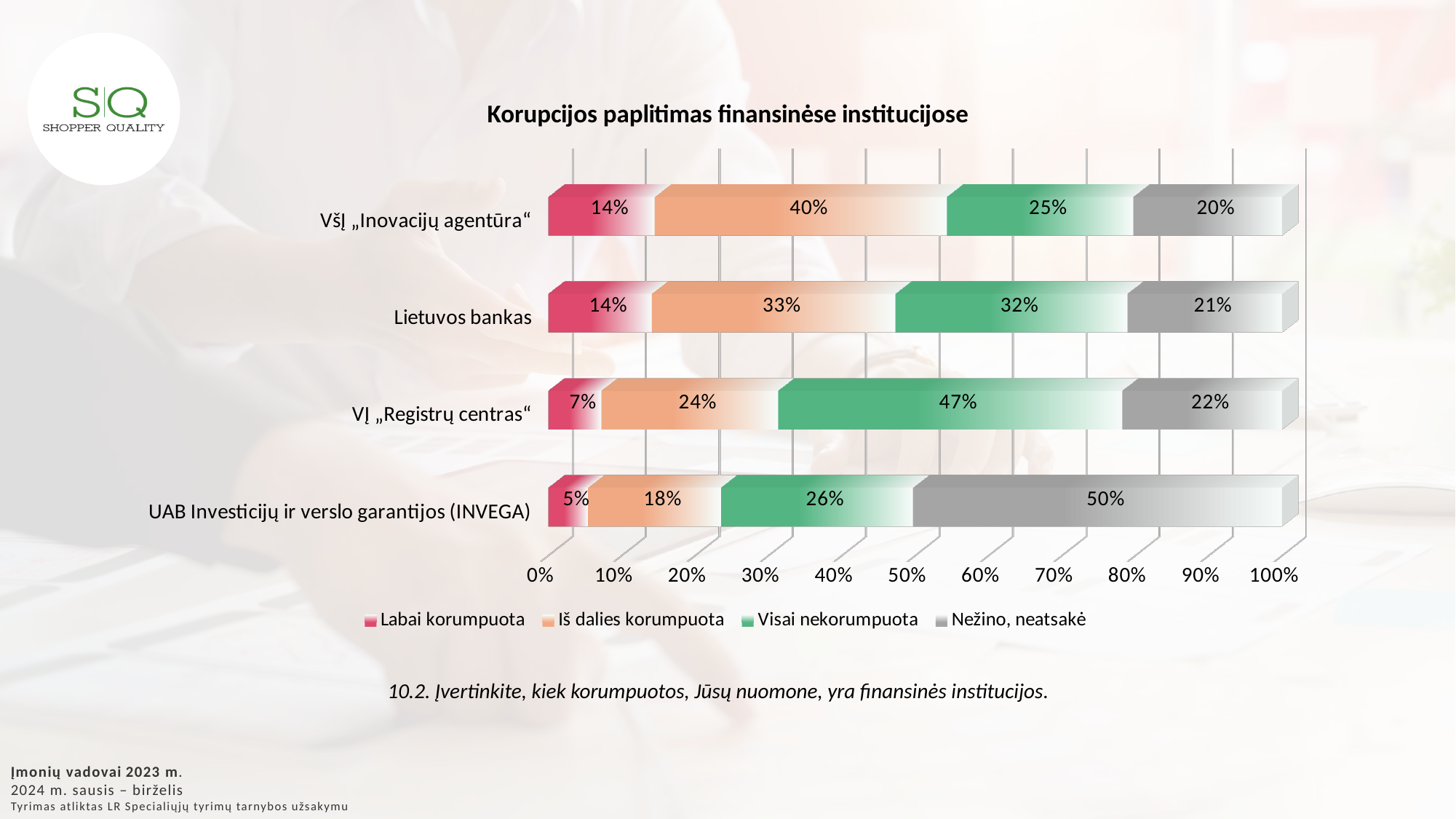
What is the value of "Nežino, neatsakė" for UAB Investicijų ir verslo garantijos (INVEGA)? 50% What is the title of the chart? Korupcijos paplitimas finansinėse institucijose What is the difference between the "Nežino, neatsakė" values for UAB Investicijų ir verslo garantijos (INVEGA) and VšĮ „Inovacijų agentūra“? 30% Which institution has the highest "Visai nekorumpuota" value? VĮ „Registrų centras“ How many series does the legend list? 4 How many institutions are shown on the chart? 4 What kind of chart is shown on the slide? Stacked bar chart What is the value of "Visai nekorumpuota" for VĮ „Registrų centras“? 47% Which institution has the lowest "Labai korumpuota" value? UAB Investicijų ir verslo garantijos (INVEGA) What is the value of "Labai korumpuota" for Lietuvos bankas? 14% Which is larger: the "Iš dalies korumpuota" value for Lietuvos bankas or for VĮ „Registrų centras“? Lietuvos bankas What is the value of "Iš dalies korumpuota" for VšĮ „Inovacijų agentūra“? 40%